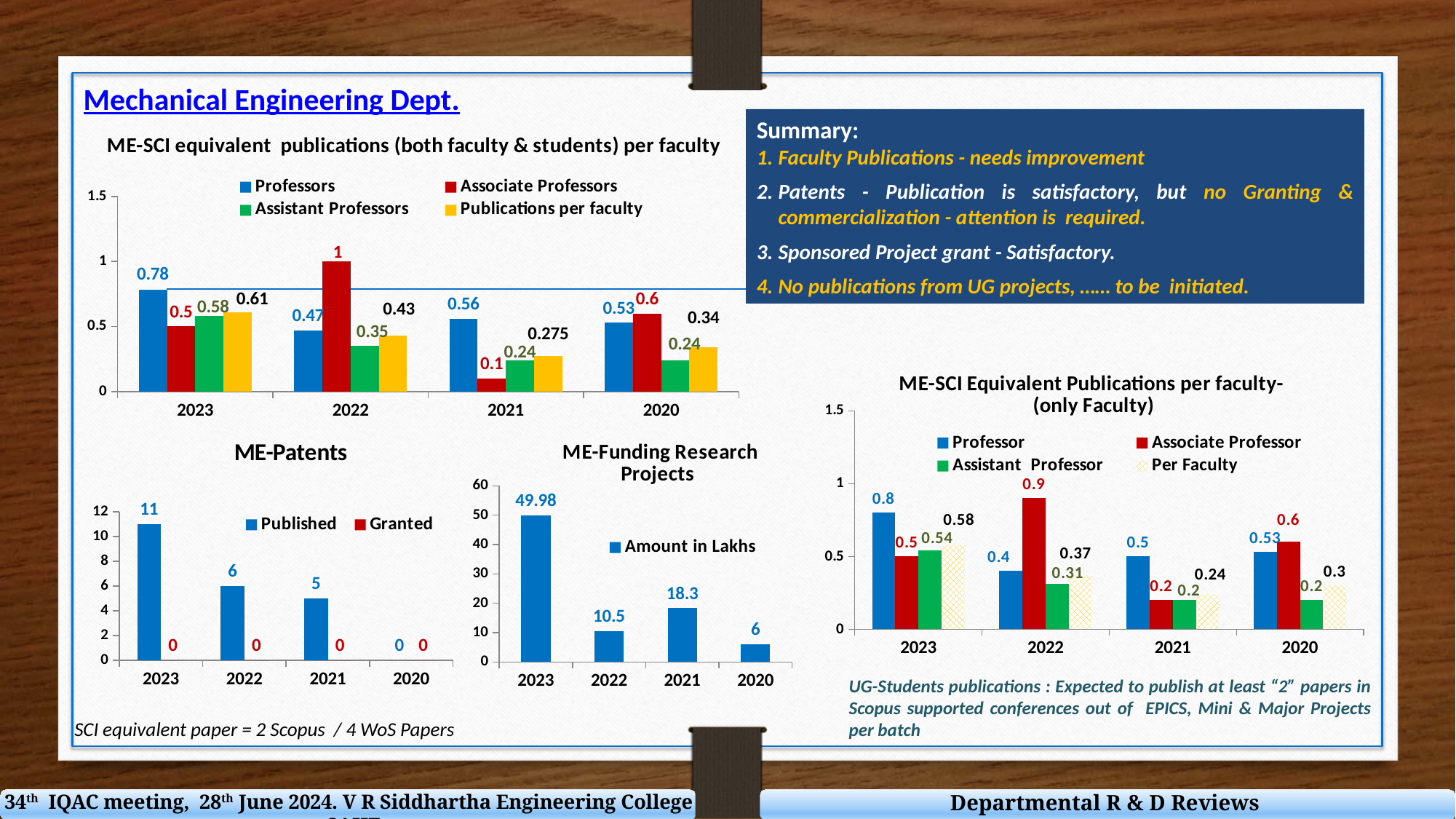
In the ME-SCI Equivalent Publications per faculty (only Faculty) chart, what is the Associate Professor value for 2022? 0.9 How many series does the legend of the ME-SCI equivalent publications (both faculty & students) per faculty chart list? 4 In the ME-SCI equivalent publications (both faculty & students) per faculty chart, what is the difference between the Professors value and the Associate Professors value in 2021? 0.46 How many years are shown on the x axis of the ME-Patents chart? 4 In the ME-Funding Research Projects chart, which year has the highest amount? 2023 In the ME-SCI equivalent publications (both faculty & students) per faculty chart, what is the value for Associate Professors in 2022? 1 In the ME-Patents chart, how many patents were published in 2023? 11 In the ME-Funding Research Projects chart, what is the amount in lakhs for 2021? 18.3 What kind of chart is the ME-Funding Research Projects chart? Bar chart In the ME-Patents chart, how many patents were granted in 2022? 0 In the ME-Funding Research Projects chart, which year has the lowest amount? 2020 In the ME-SCI Equivalent Publications per faculty (only Faculty) chart, which is larger in 2020: the Professor value or the Associate Professor value? Associate Professor